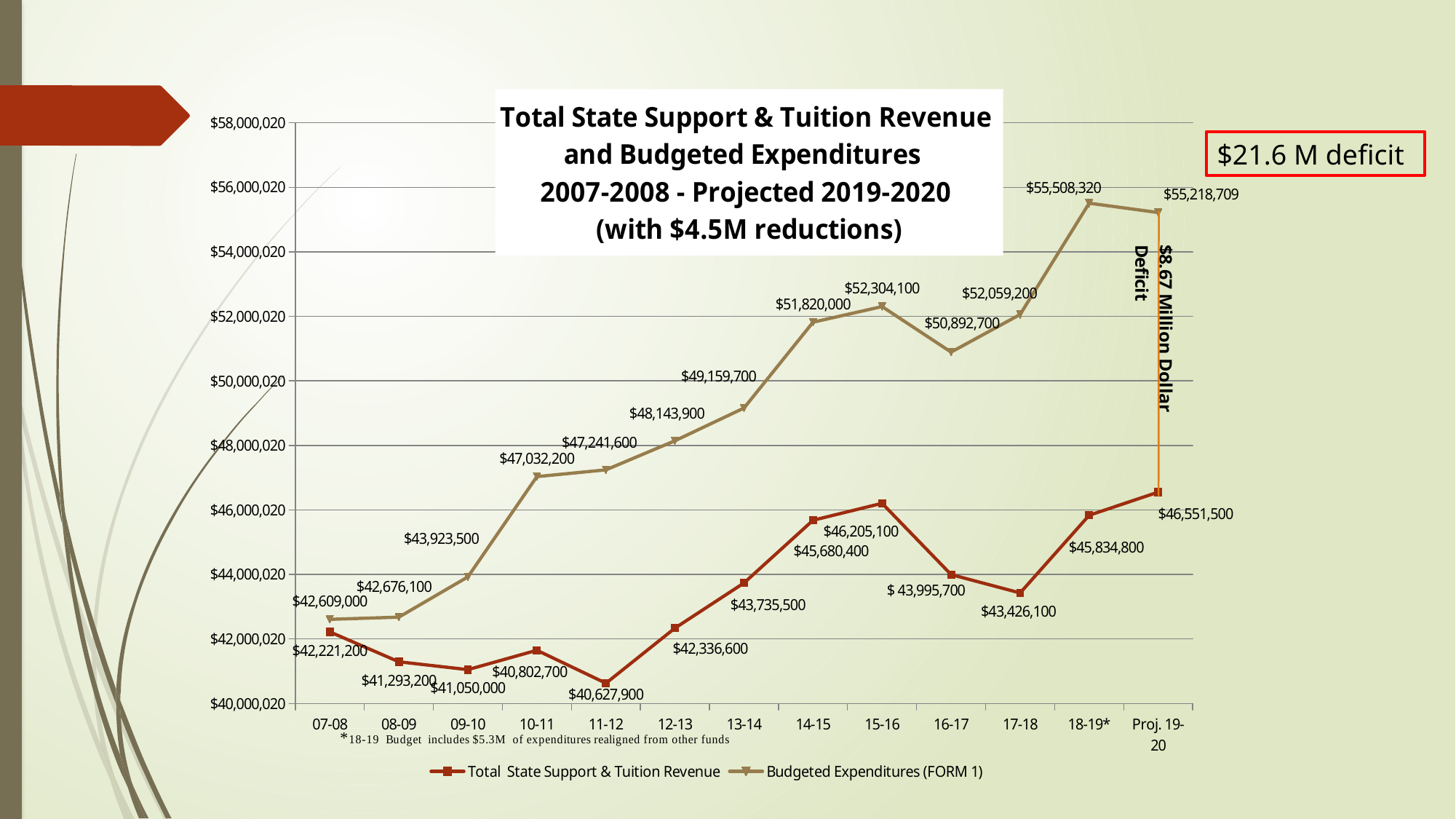
What is the Total State Support & Tuition Revenue value for 16-17? $43,995,700 What is the Budgeted Expenditures (FORM 1) value for 18-19*? $55,508,320 In which year is Total State Support & Tuition Revenue lowest? 11-12 In which year is Budgeted Expenditures (FORM 1) highest? 18-19* Which year has the higher Total State Support & Tuition Revenue, 15-16 or 18-19*? 15-16 Does Budgeted Expenditures (FORM 1) generally rise or fall from 07-08 to 18-19*? Rise What kind of chart is shown on the slide? Line chart How many years are plotted on the x axis? 13 How much did Total State Support & Tuition Revenue fall from 15-16 to 16-17? $2,209,400 For Proj. 19-20, how much larger is Budgeted Expenditures (FORM 1) than Total State Support & Tuition Revenue? $8,667,209 What is the Total State Support & Tuition Revenue value for 11-12? $40,627,900 How many series does the legend list? 2